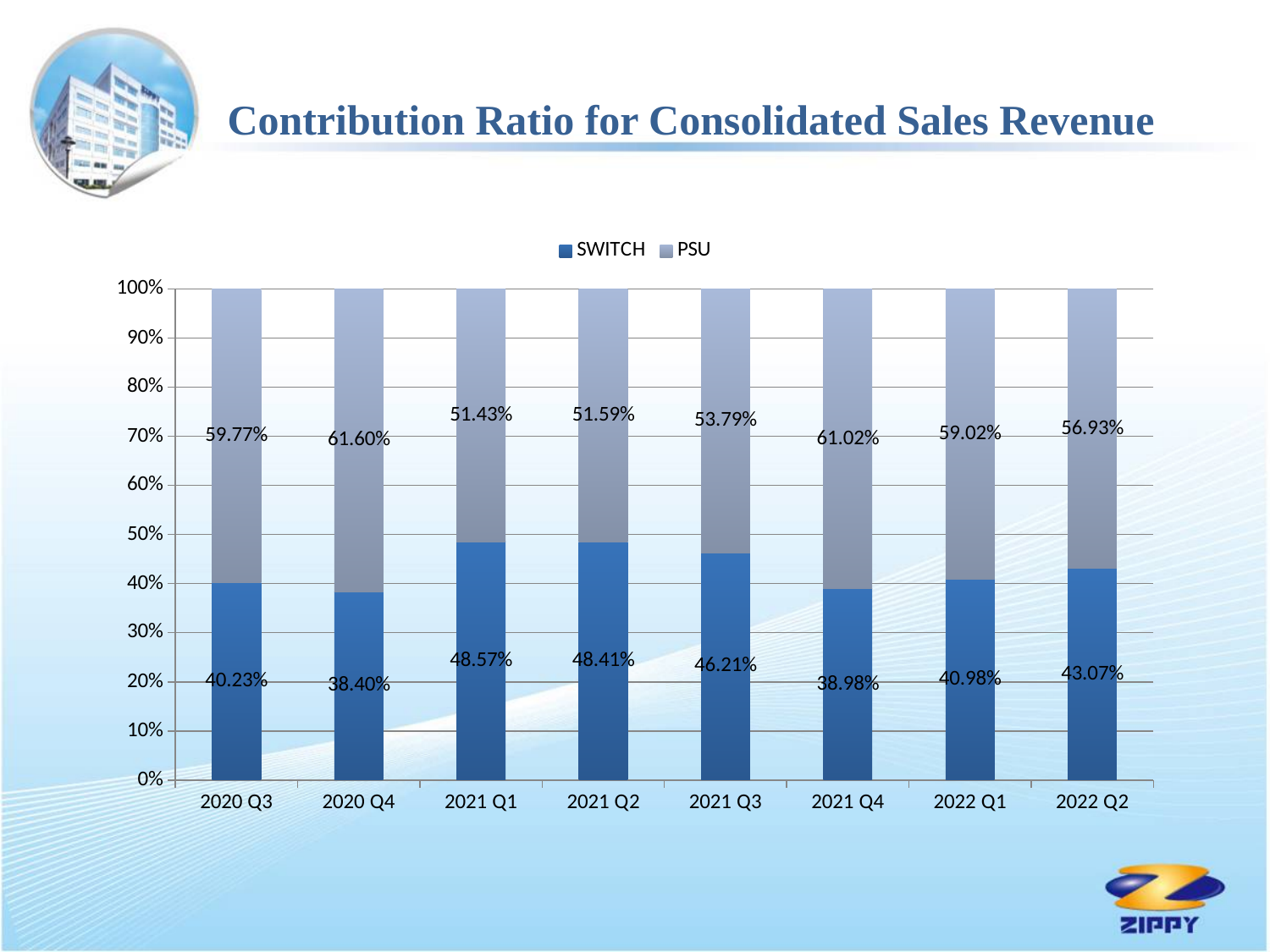
How many series does the legend list? 2 What is the total of the stacked bar for 2021 Q4? 100% What is the difference between the PSU and SWITCH contribution ratios in 2022 Q2? 13.86% In which quarter is the PSU contribution ratio the highest? 2020 Q4 In which quarter is the SWITCH contribution ratio the lowest? 2020 Q4 Is the SWITCH contribution ratio for 2021 Q2 greater or less than 40%? greater How many quarters are shown on the x axis? 8 What is the PSU contribution ratio for 2020 Q4? 61.60% What is the PSU contribution ratio for 2022 Q2? 56.93% What kind of chart is shown on the slide? Stacked bar chart What is the SWITCH contribution ratio for 2021 Q1? 48.57% Which is larger in 2021 Q3, the SWITCH ratio or the PSU ratio? PSU